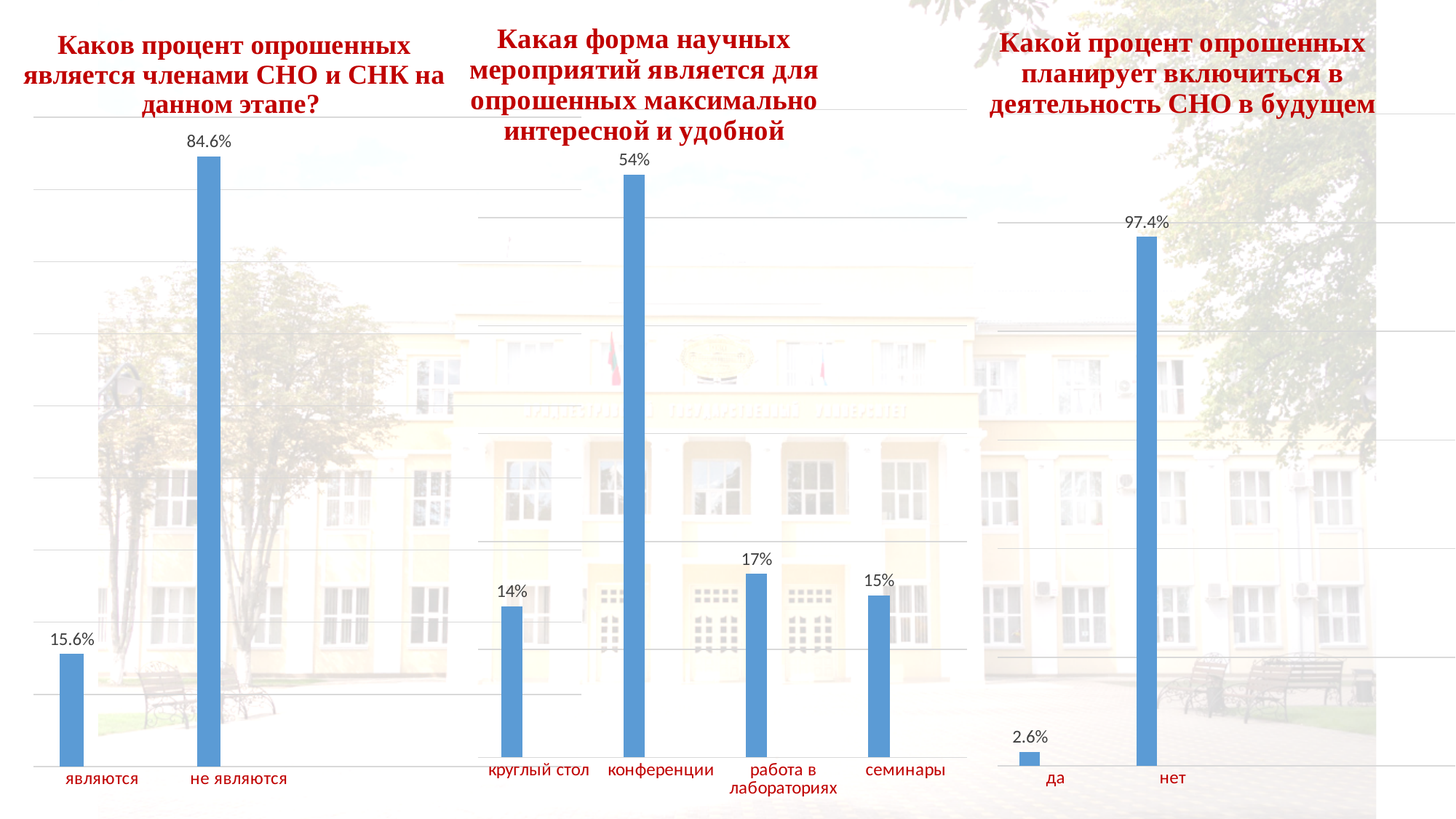
In the middle chart, which category has the highest value? конференции In the middle chart, what is the value for "конференции"? 54% In the left chart, what is the value for "не являются"? 84.6% In the middle chart, how many categories are shown? 4 In the left chart, what is the difference between "не являются" and "являются"? 69% In the left chart, what is the value for "являются"? 15.6% In the right chart, what is the value for "да"? 2.6% In the middle chart, which category has the lowest value? круглый стол How many charts are on the slide? 3 In the right chart, which is larger, "да" or "нет"? нет In the middle chart, what is the difference between "работа в лабораториях" and "семинары"? 2% What type of chart is the right chart? bar chart